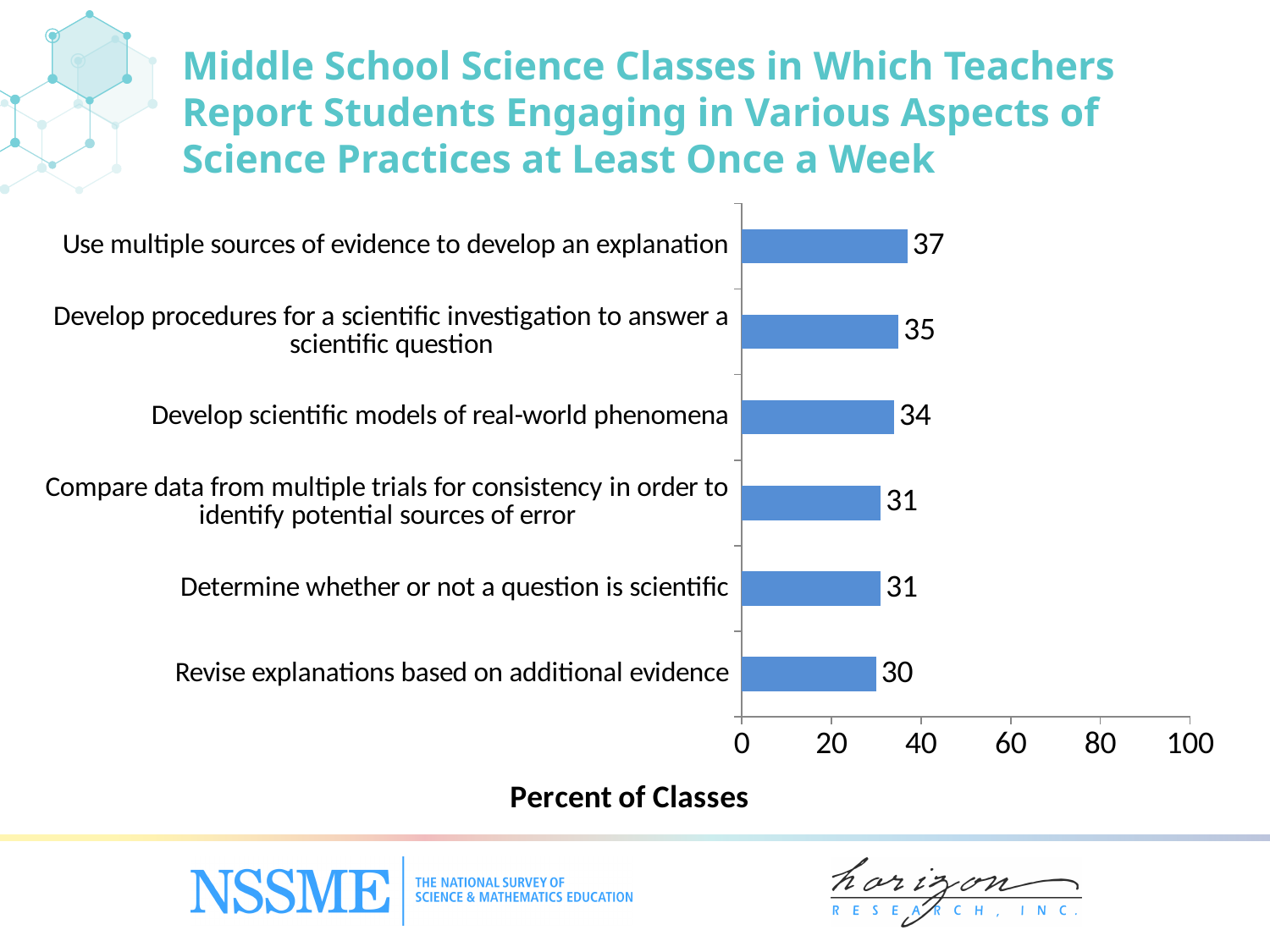
What is the value for "Determine whether or not a question is scientific"? 31 Which category has the lowest percent of classes? Revise explanations based on additional evidence Which category has the highest percent of classes? Use multiple sources of evidence to develop an explanation What is the difference between the values for "Use multiple sources of evidence to develop an explanation" and "Revise explanations based on additional evidence"? 7 How many categories are shown in the chart? 6 What percent of classes is reported for "Use multiple sources of evidence to develop an explanation"? 37 What is the label of the horizontal axis? Percent of Classes Which is larger: the value for "Develop procedures for a scientific investigation to answer a scientific question" or for "Develop scientific models of real-world phenomena"? Develop procedures for a scientific investigation to answer a scientific question Is the value for "Compare data from multiple trials for consistency in order to identify potential sources of error" greater or less than 40? less What is the value for "Develop scientific models of real-world phenomena"? 34 What is the value for "Revise explanations based on additional evidence"? 30 What kind of chart is shown on the slide? bar chart